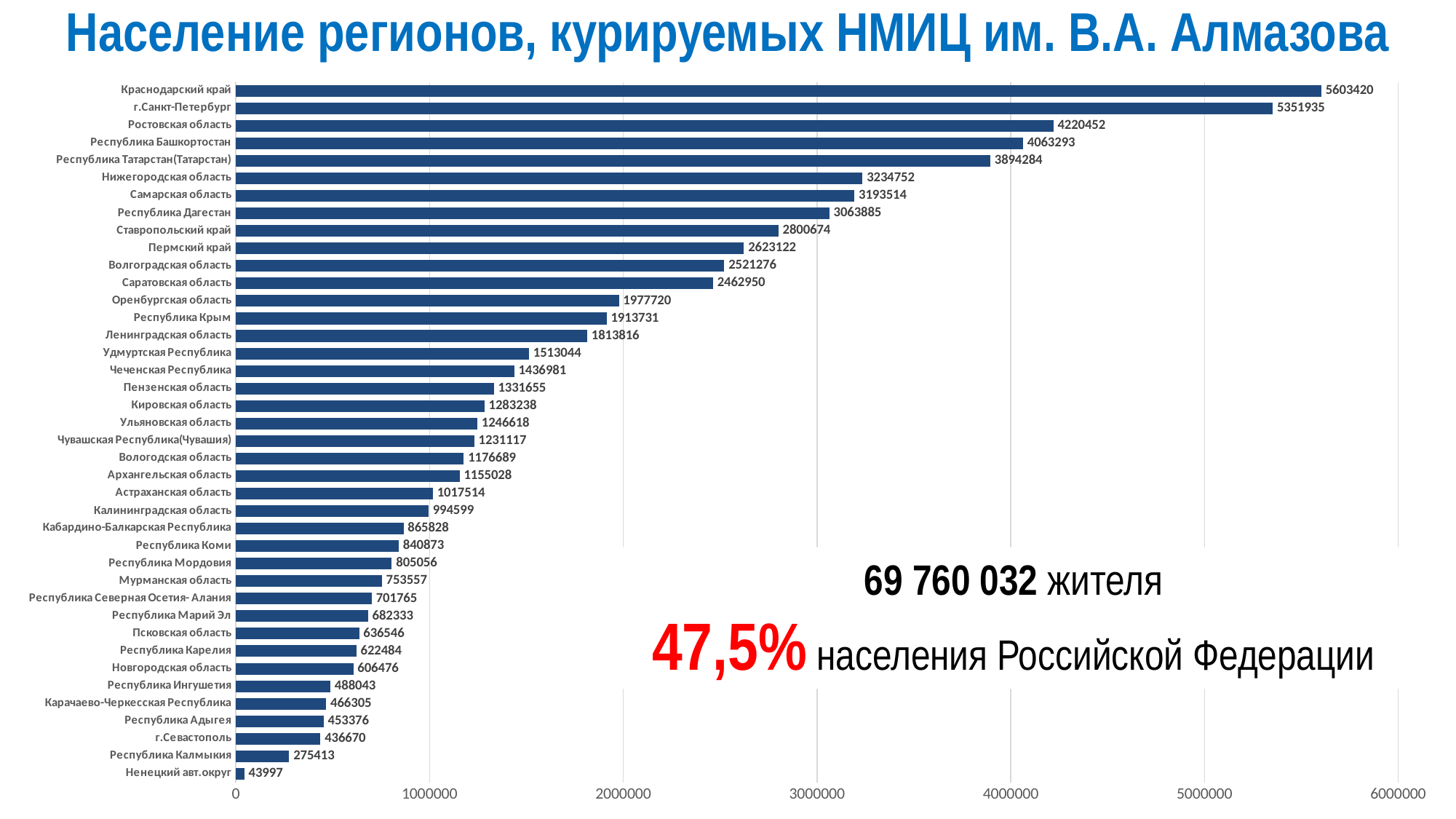
What is the title of the slide? Население регионов, курируемых НМИЦ им. В.А. Алмазова What kind of chart is shown on the slide? bar chart What is the population value shown for Ненецкий авт.округ? 43997 How many regions are shown on the chart? 40 Which has a larger population, Ростовская область or Республика Башкортостан? Ростовская область What is the population value shown for Краснодарский край? 5603420 Is the value for Нижегородская область greater or less than 3000000? greater Which region has the lowest population on the chart? Ненецкий авт.округ Which region has the highest population on the chart? Краснодарский край What is the difference between the populations of Краснодарский край and г.Санкт-Петербург? 251485 What is the population value shown for Республика Крым? 1913731 What percentage of the population of the Russian Federation is stated on the slide? 47,5%